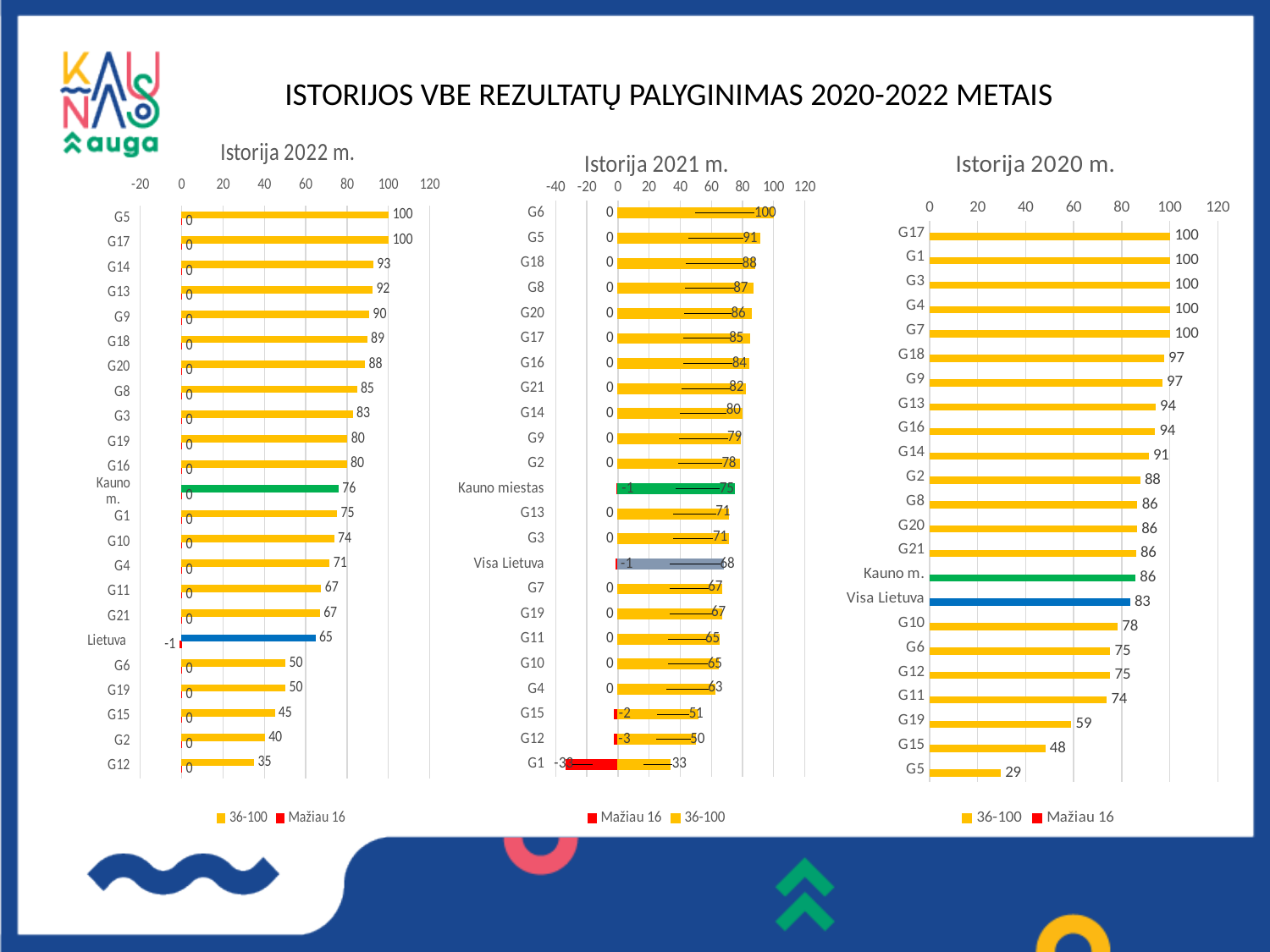
In the 'Istorija 2022 m.' chart, which is larger, the value for G14 or the value for G10? G14 In the 'Istorija 2020 m.' chart, what is the value for Visa Lietuva? 83 In the 'Istorija 2021 m.' chart, which category has the highest 36-100 value? G6 How many series does the legend of the 'Istorija 2020 m.' chart list? 2 In the 'Istorija 2021 m.' chart, what is the Mažiau 16 value for G1? -33 In the 'Istorija 2020 m.' chart, what is the difference between the values for G17 and G5? 71 In the 'Istorija 2021 m.' chart, what is the difference between the 36-100 values for G5 and G4? 28 In the 'Istorija 2020 m.' chart, which category has the lowest value? G5 In the 'Istorija 2022 m.' chart, which category has the lowest value? G12 In the 'Istorija 2021 m.' chart, what is the 36-100 value for Kauno miestas? 75 What type of chart is 'Istorija 2022 m.'? Bar chart In the 'Istorija 2022 m.' chart, what is the value for Kauno m.? 76